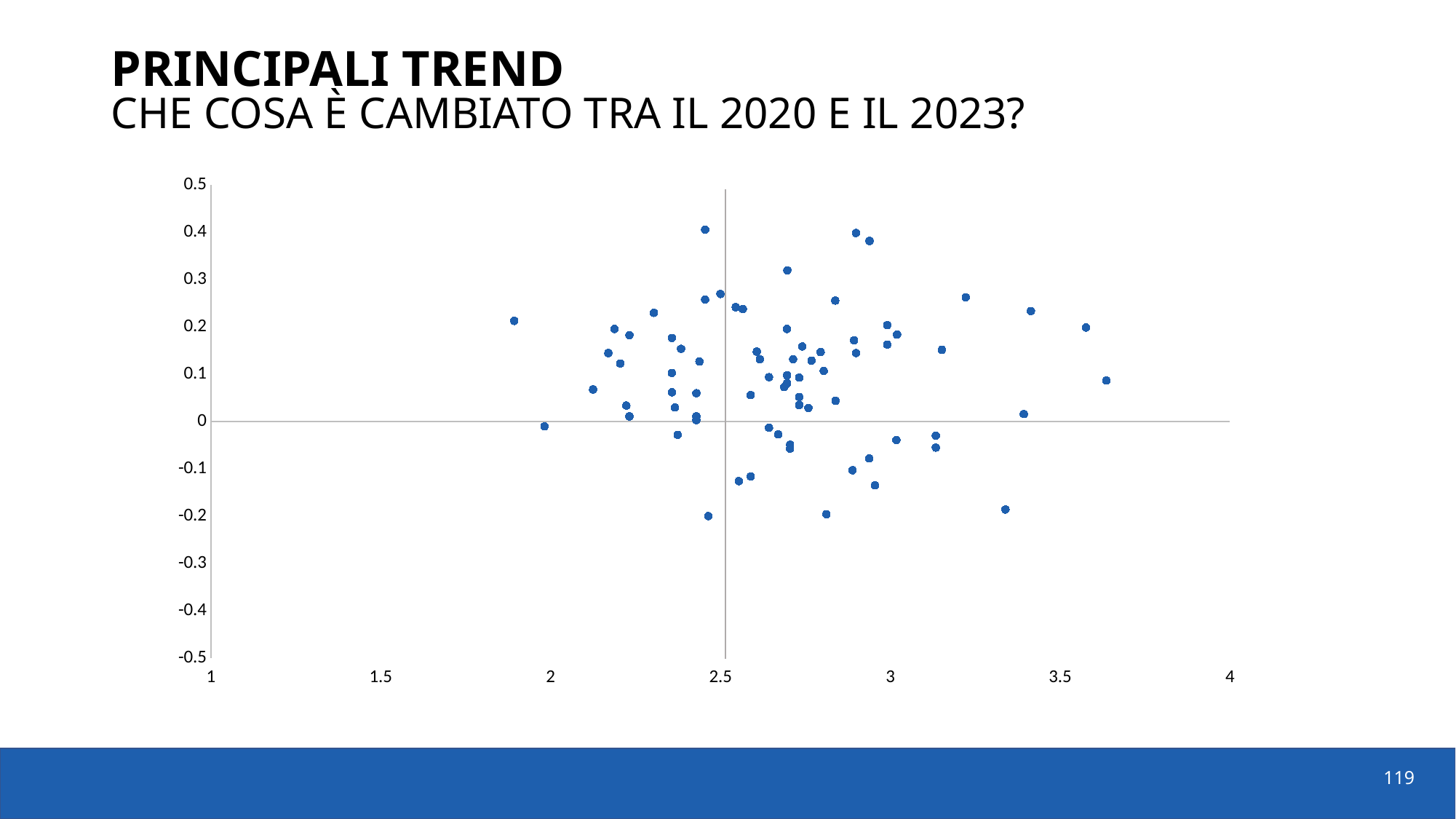
Is the y value of the leftmost point in the chart greater or less than 0.1? greater Is the y value of the rightmost point in the chart greater or less than 0.2? less Are there any points in the chart with an x value greater than 3.5? Yes What is the lowest value shown on the x axis of the chart? 1 What is the highest value shown on the y axis of the chart? 0.5 What kind of chart is shown on the slide? scatter chart